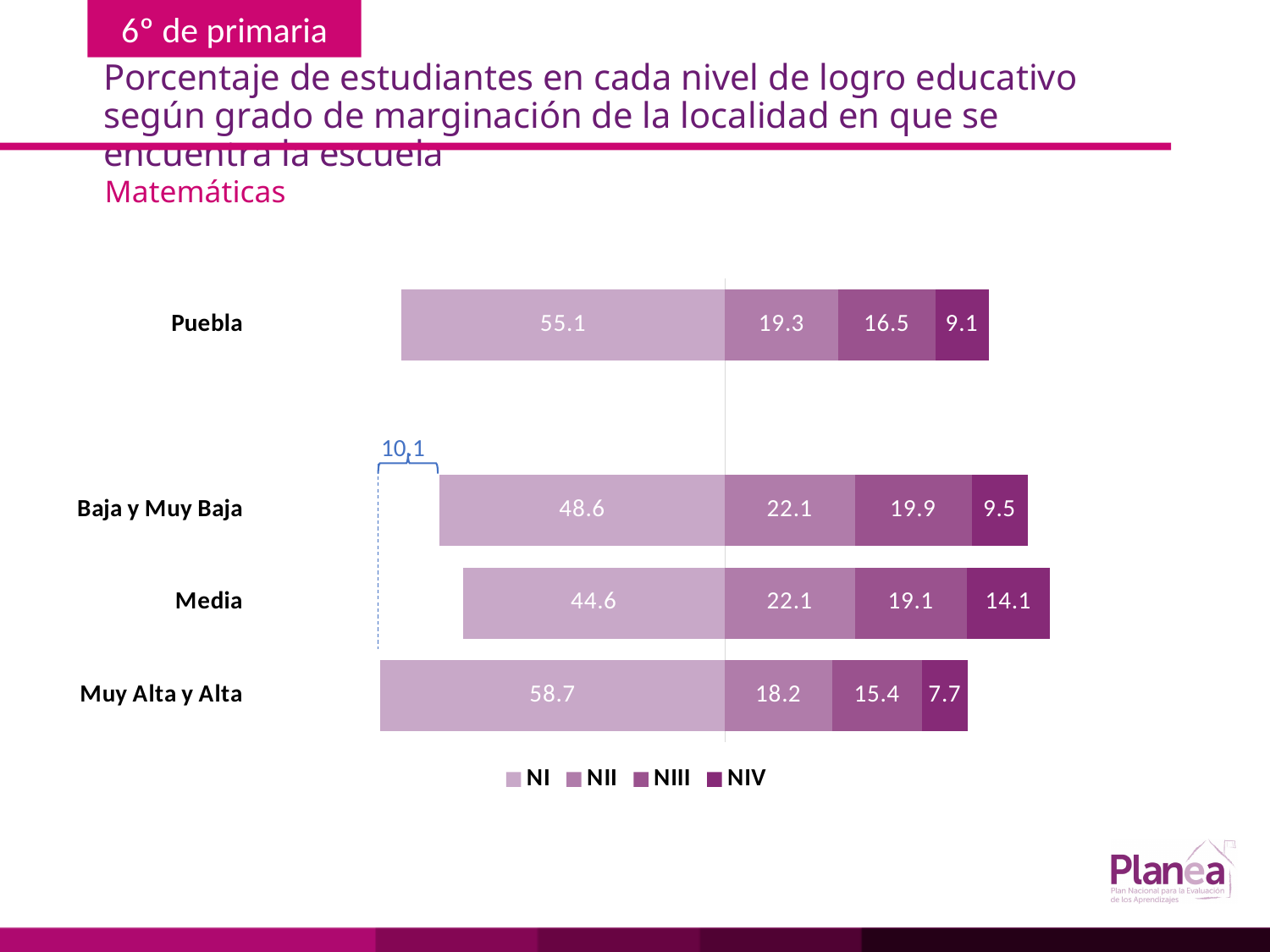
Which category has the lowest NIV value? Muy Alta y Alta What is the difference between the NI values for Muy Alta y Alta and Media? 14.1 What is the NII value for Muy Alta y Alta? 18.2 What is the NIV value for Media? 14.1 Which is larger, the NIV value for Media or the NIV value for Puebla? Media How many series does the legend list? 4 What is the NIII value for Baja y Muy Baja? 19.9 What is the NI value for Puebla? 55.1 Which category has the highest NI value? Muy Alta y Alta What kind of chart is shown on the slide? Stacked bar chart How many categories are shown on the chart? 4 What is the total of the stacked bar for Puebla? 100.0